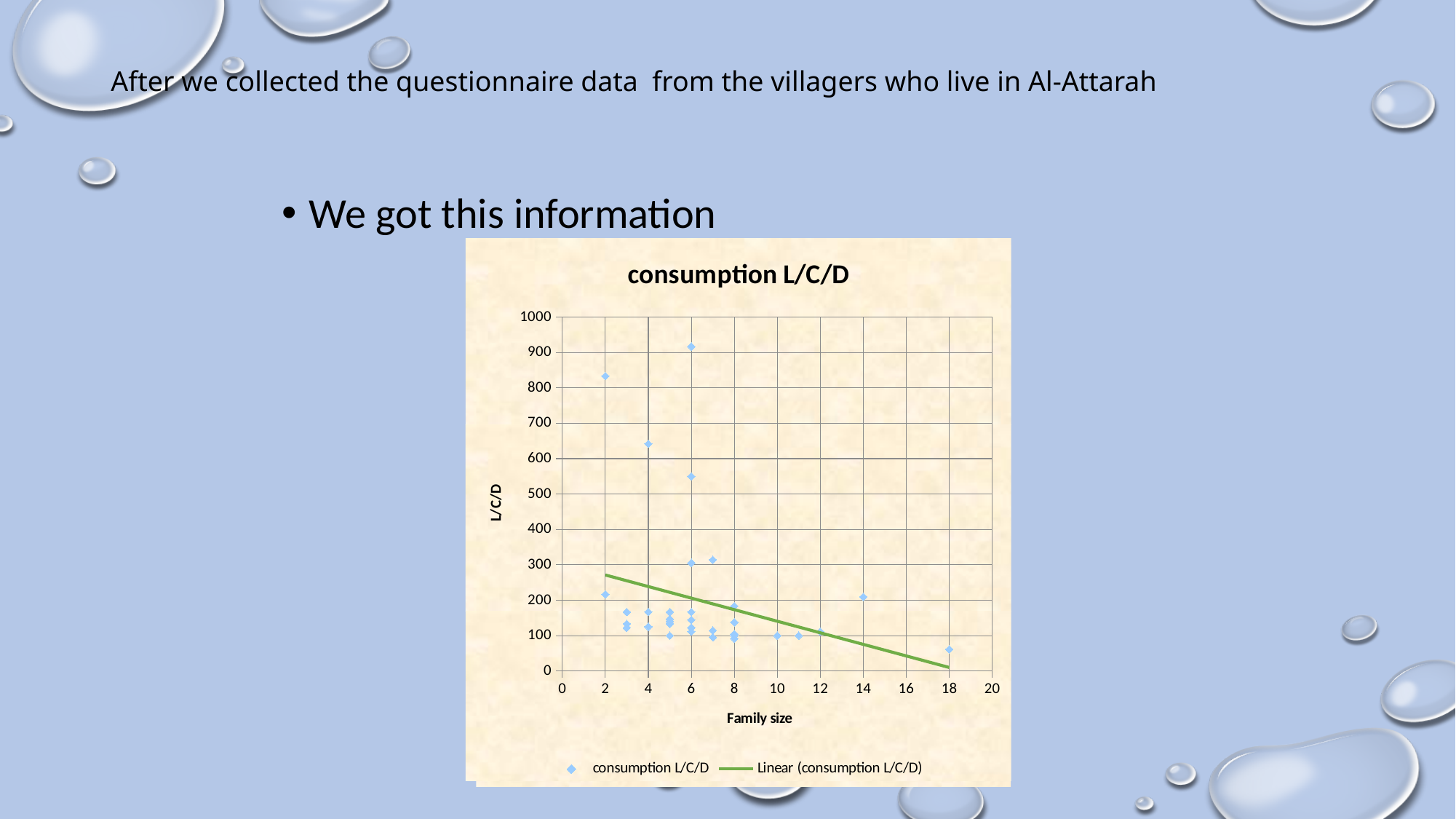
Is the highest consumption value plotted at family size 2 greater or less than 800? greater At which family size is the highest consumption value plotted? 6 What is the maximum value shown on the y axis? 1000 Is the highest consumption value plotted at family size 4 greater or less than 600? greater What is the label of the x axis? Family size At which family size is the lowest consumption value plotted? 18 What is the title of the chart? consumption L/C/D Does the linear trendline rise or fall as family size increases? Fall Is the highest plotted consumption value greater or less than 900? greater How many entries does the chart legend list? 2 What kind of chart is shown on the slide? Scatter chart